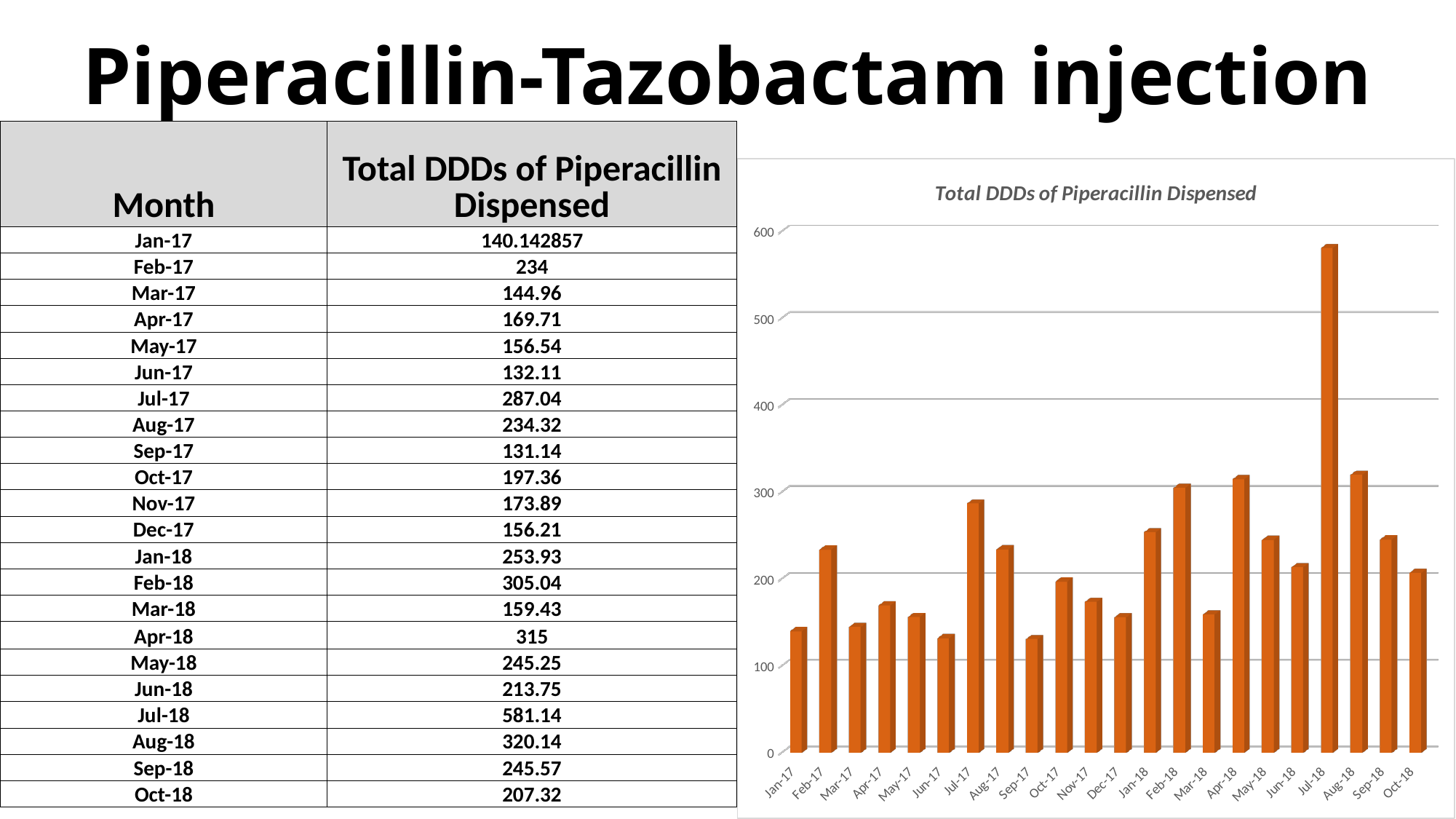
What is the difference between the values for Aug-18 and Apr-18? 5.14 Which month has the lowest total DDDs of Piperacillin dispensed? Sep-17 What is the title of the chart? Total DDDs of Piperacillin Dispensed Is the value for Jun-17 greater or less than 200? less Is the value for Jul-18 greater or less than 500? greater What is the total DDDs of Piperacillin dispensed in Feb-17? 234 Which month has the highest total DDDs of Piperacillin dispensed? Jul-18 How many months are plotted on the chart? 22 What type of chart is shown on the slide? bar chart What is the total DDDs of Piperacillin dispensed in Jul-18? 581.14 Which is larger, the value for Jul-17 or the value for Aug-17? Jul-17 What is the total DDDs of Piperacillin dispensed in Apr-18? 315